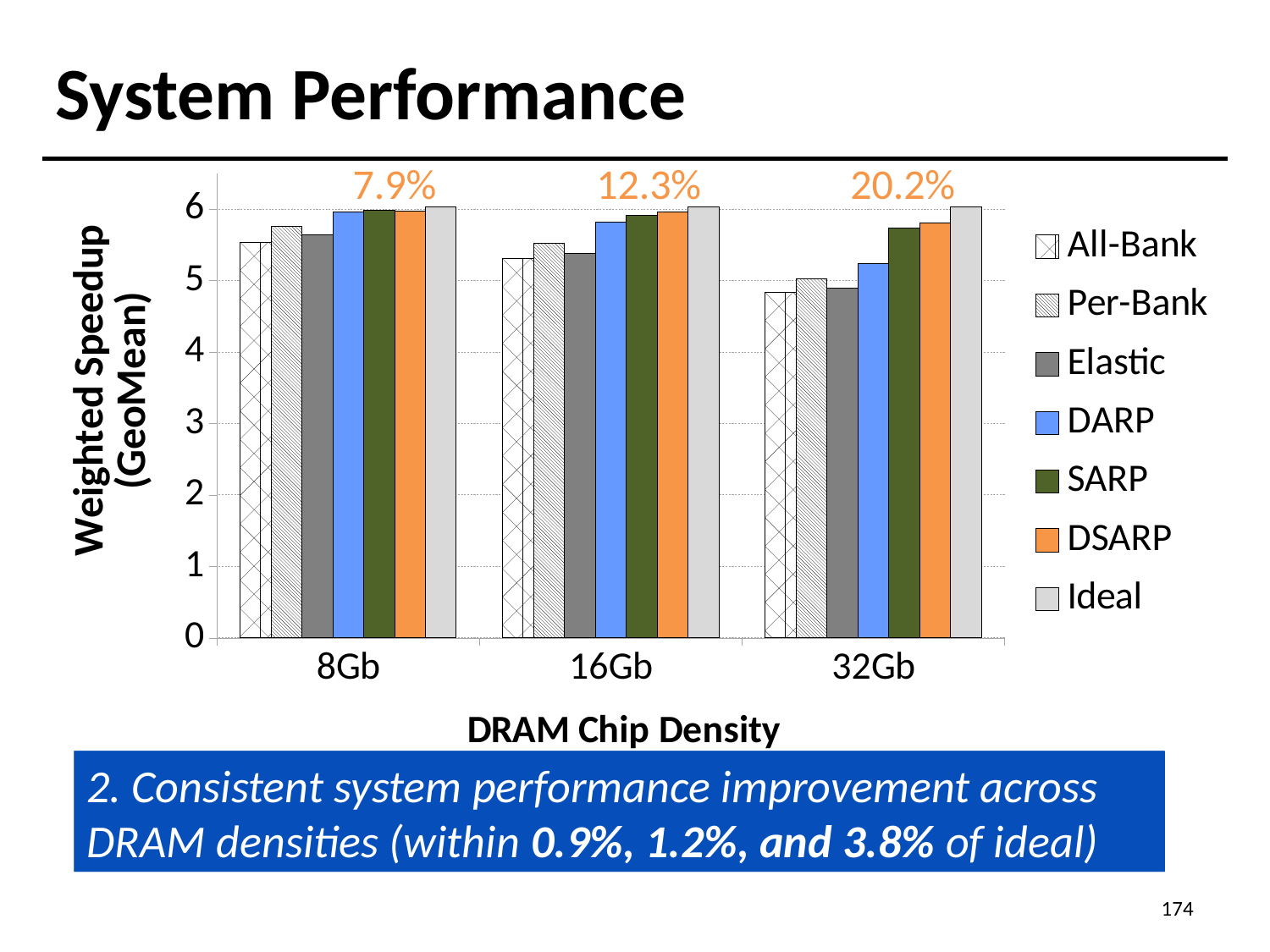
Is the value for SARP at 32Gb greater or less than 5? greater At 32Gb, which is larger, DARP or SARP? SARP What kind of chart is shown on the slide? bar chart For the All-Bank series, at which DRAM chip density is the weighted speedup lowest? 32Gb What percentage is printed above the 32Gb group of bars? 20.2% How many DRAM chip density categories are shown on the x axis? 3 Is the value for DARP at 32Gb greater or less than 5? greater Is the value for All-Bank at 8Gb greater or less than 5? greater How many series does the legend list? 7 At 32Gb, which is larger, DSARP or All-Bank? DSARP Does the All-Bank weighted speedup rise or fall as DRAM chip density increases from 8Gb to 32Gb? fall